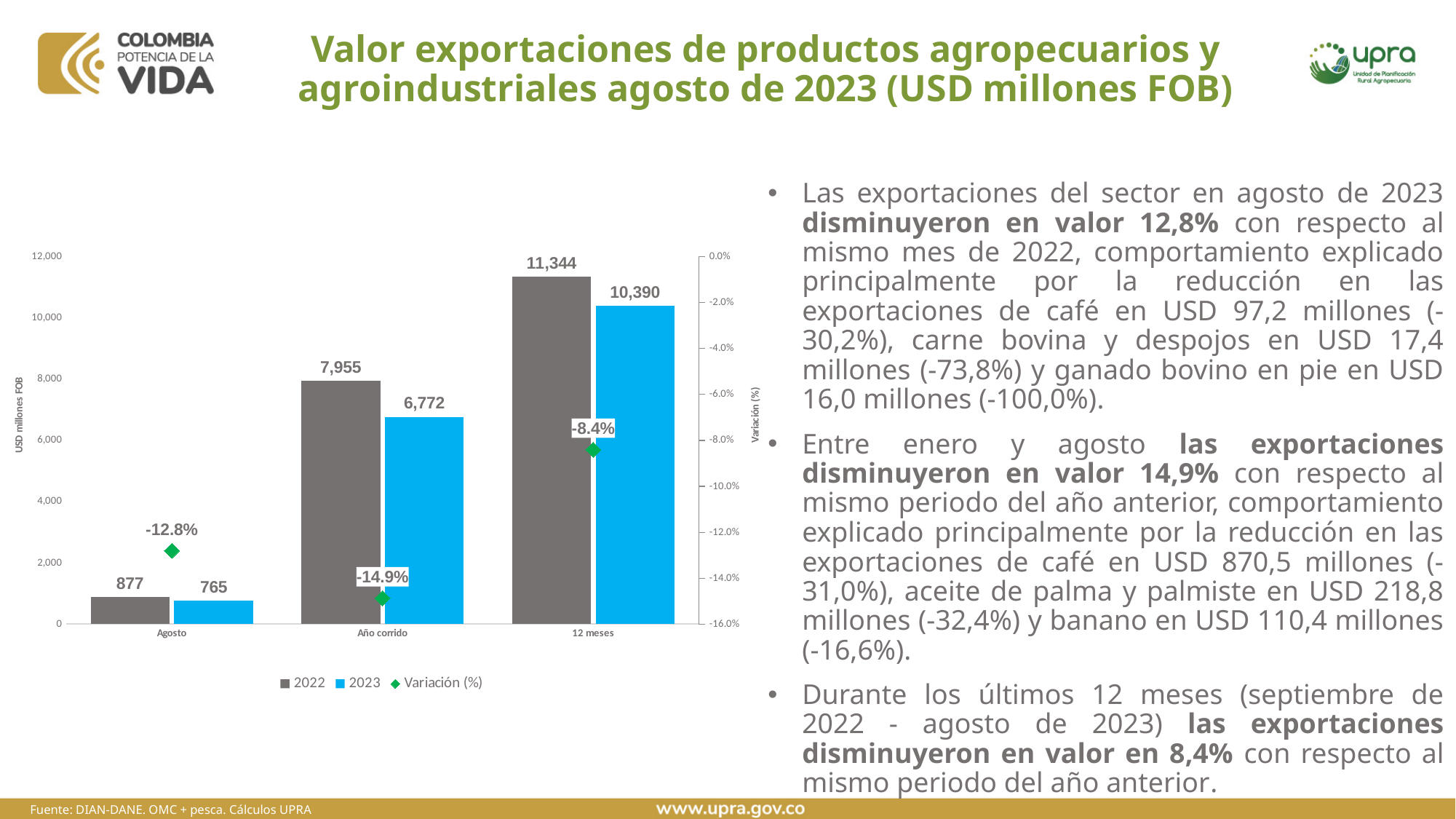
How many categories are shown on the x axis? 3 What is the label of the left vertical axis? USD millones FOB Which category has the lowest 2023 value? Agosto What kind of chart is shown on the slide? Bar chart with a line/marker series Which category has the highest 2022 value? 12 meses What is the 2023 value for 12 meses? 10,390 What is the 2023 value for Año corrido? 6,772 Which is larger for 12 meses, the 2022 value or the 2023 value? 2022 How many series does the legend list? 3 What is the difference between the 2022 and 2023 values for Año corrido? 1,183 What is the 2022 value for Agosto? 877 What is the Variación (%) value for 12 meses? -8.4%